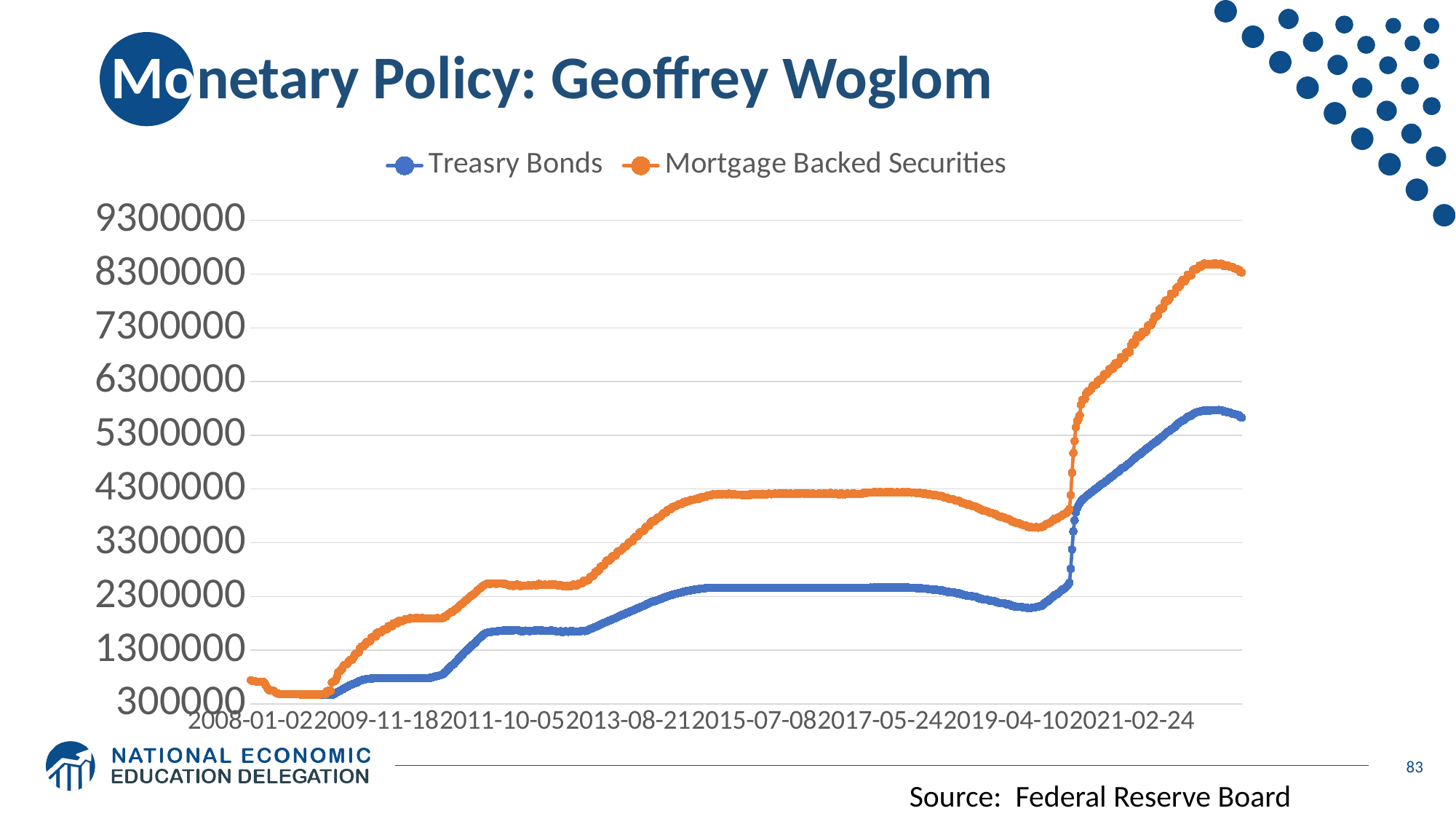
Is the value for Treasry Bonds around 2017-05-24 greater or less than 3300000? less What is the highest value shown on the vertical axis? 9300000 How many series does the legend list? 2 Is the value for Mortgage Backed Securities around 2017-05-24 greater or less than 3300000? greater What are the two series named in the legend? Treasry Bonds and Mortgage Backed Securities Which colour is used for the Mortgage Backed Securities series? Orange Which series reaches the higher value at the right end of the chart? Mortgage Backed Securities Which series has the higher peak value over the whole period? Mortgage Backed Securities What kind of chart is shown on the slide? Line chart Is the value for Mortgage Backed Securities at the right end of the chart greater or less than 7300000? greater Overall, do the values for Treasry Bonds rise or fall from the left of the chart to the right? Rise